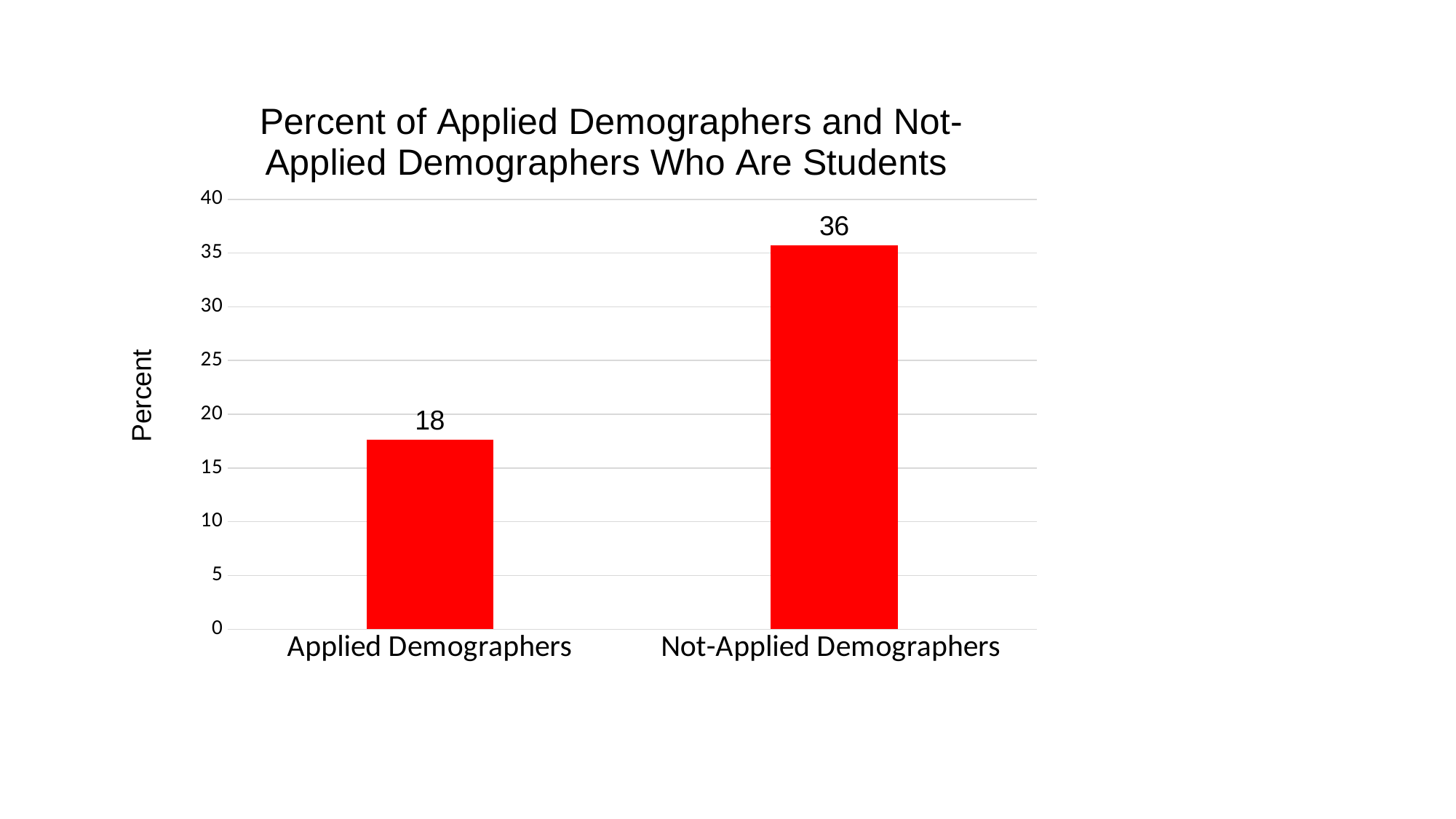
Which category has the highest value? Not-Applied Demographers How many categories are shown on the chart? 2 Which category has the lowest value? Applied Demographers What is the difference between the values for Not-Applied Demographers and Applied Demographers? 18 Is the value for Applied Demographers greater or less than 20? less What is the value for Applied Demographers? 18 Is the value for Not-Applied Demographers greater or less than 30? greater Which is larger, the value for Applied Demographers or the value for Not-Applied Demographers? Not-Applied Demographers What is the title of the chart? Percent of Applied Demographers and Not-Applied Demographers Who Are Students What kind of chart is shown on the slide? bar chart What is the value for Not-Applied Demographers? 36 What is the label on the vertical axis? Percent